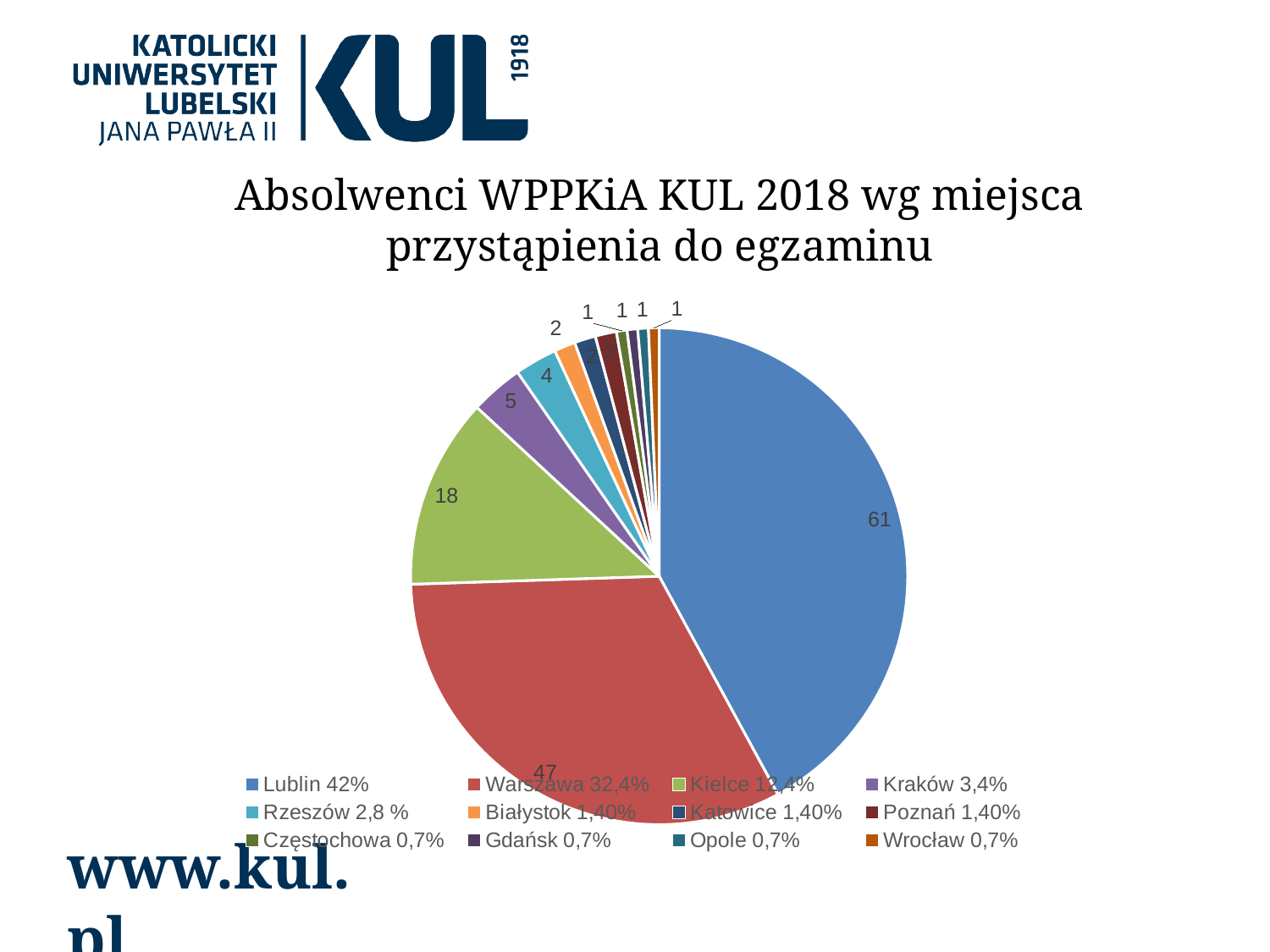
What is the value shown for Lublin? 61 What is the value shown for Kielce? 18 What is the value shown for Rzeszów? 4 What is the value shown for Kraków? 5 What kind of chart is shown on the slide? pie chart What share of the pie does Lublin represent, according to the legend? 42% Which is larger, the value for Kielce or the value for Kraków? Kielce What is the value shown for Warszawa? 47 What is the difference between the values for Lublin and Warszawa? 14 How many categories (slices) does the pie chart have? 12 Which city has the largest slice of the pie? Lublin What is the title of the chart? Absolwenci WPPKiA KUL 2018 wg miejsca przystąpienia do egzaminu